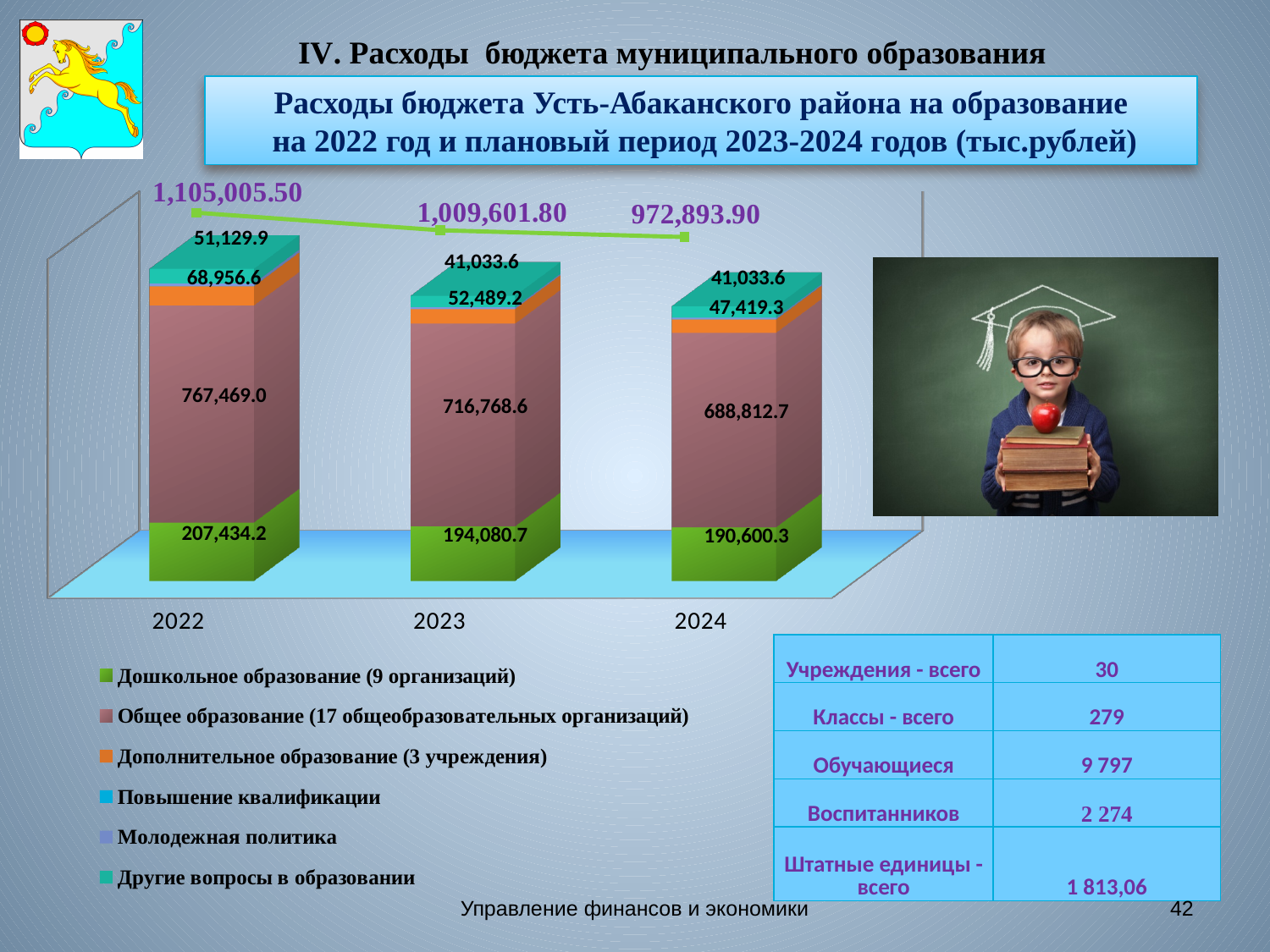
Is the Дошкольное образование value larger in 2022 or in 2023? 2022 What kind of chart is used to show the education expenditures? Stacked bar chart How many years are shown on the x axis of the chart? 3 How many series does the chart legend list? 6 Which year has the lowest value for Дошкольное образование? 2024 Which year has the highest total education expenditure? 2022 What is the total education expenditure shown for 2022? 1,105,005.50 What is the value for Общее образование in 2023? 716,768.6 Do the total education expenditures rise or fall from 2022 to 2024? Fall What is the difference between the Общее образование values for 2022 and 2024? 78,656.3 What is the value for Дошкольное образование in 2024? 190,600.3 What is the total education expenditure shown for 2024? 972,893.90